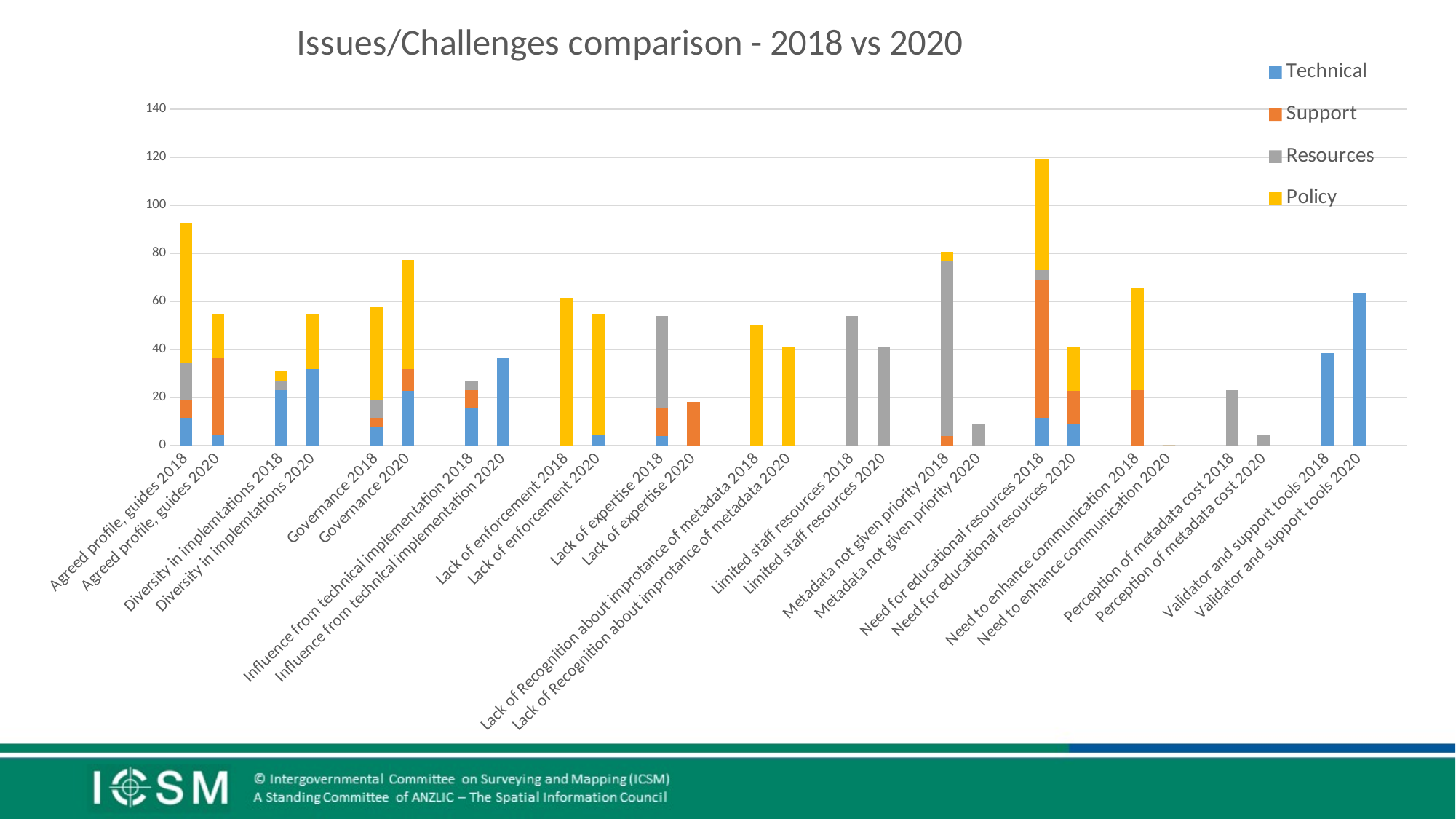
What kind of chart is shown on the slide? Stacked bar chart Is the total value for Lack of enforcement 2018 greater or less than 40? greater What is the title of the chart? Issues/Challenges comparison - 2018 vs 2020 Is the total value for Lack of expertise 2018 greater or less than 40? greater Is the total value for Agreed profile, guides 2018 greater or less than 80? greater Which category has the tallest stacked bar overall? Need for educational resources 2018 Which has the taller bar: Validator and support tools 2018 or Validator and support tools 2020? Validator and support tools 2020 Which has the taller bar: Agreed profile, guides 2018 or Agreed profile, guides 2020? Agreed profile, guides 2018 How many series does the legend list? 4 Which series is shown in yellow in the legend? Policy